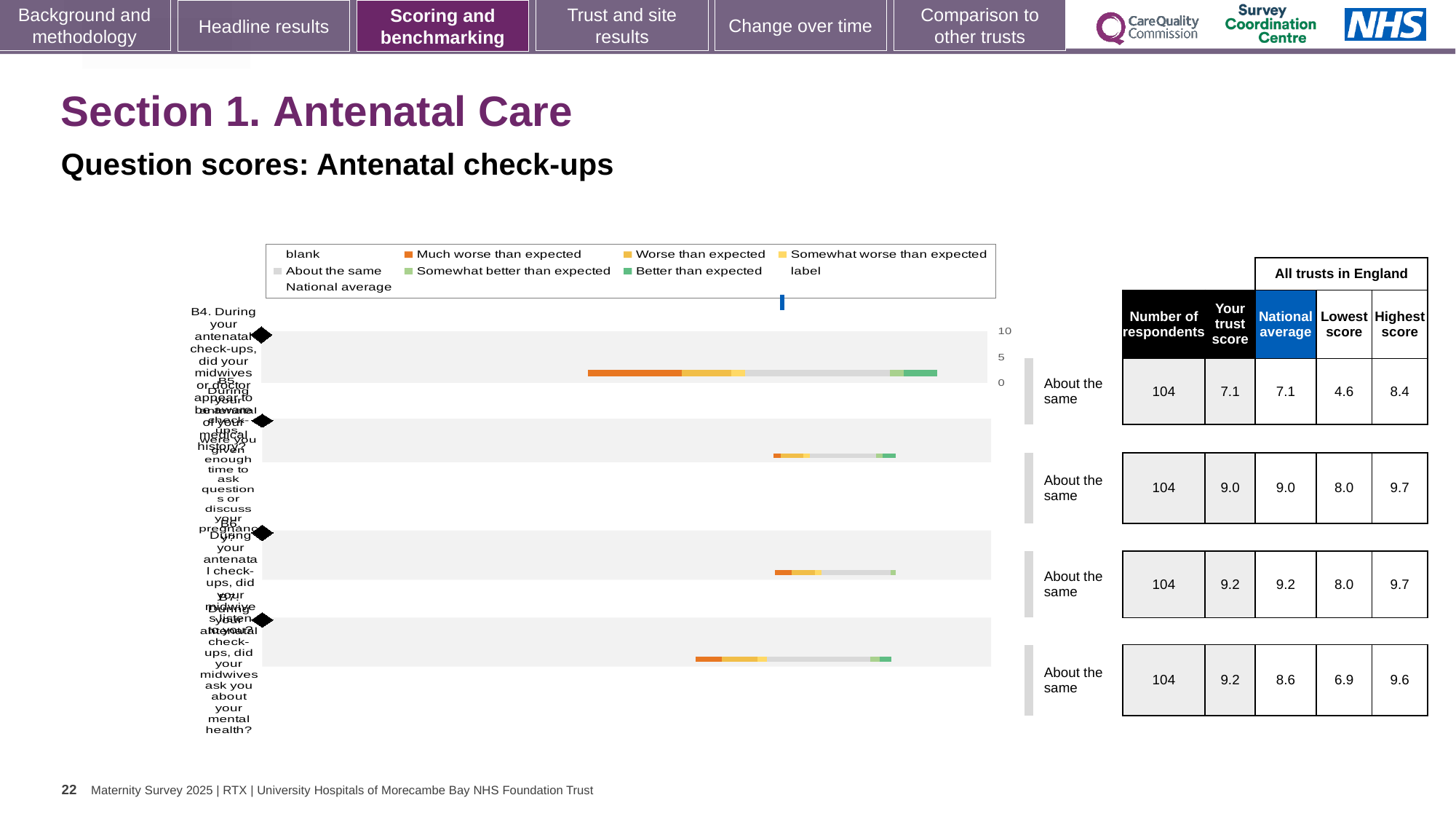
In the table, what is the trust score for question B7 (mental health)? 9.2 In the table, which question has the lowest trust score? B4 In the table, what is the lowest score for question B4? 4.6 How many question rows (categories) are plotted in the chart? 4 How many entries does the chart legend list? 9 For question B7, what is the difference between the trust score and the national average? 0.6 For question B7, is the trust score or the national average larger? trust score What colour does the legend use for 'Much worse than expected'? orange In the table, what is the number of respondents for question B4? 104 What kind of chart is shown on the slide? bar chart What is the subtitle above the chart? Question scores: Antenatal check-ups In the table, what is the national average for question B7 (mental health)? 8.6